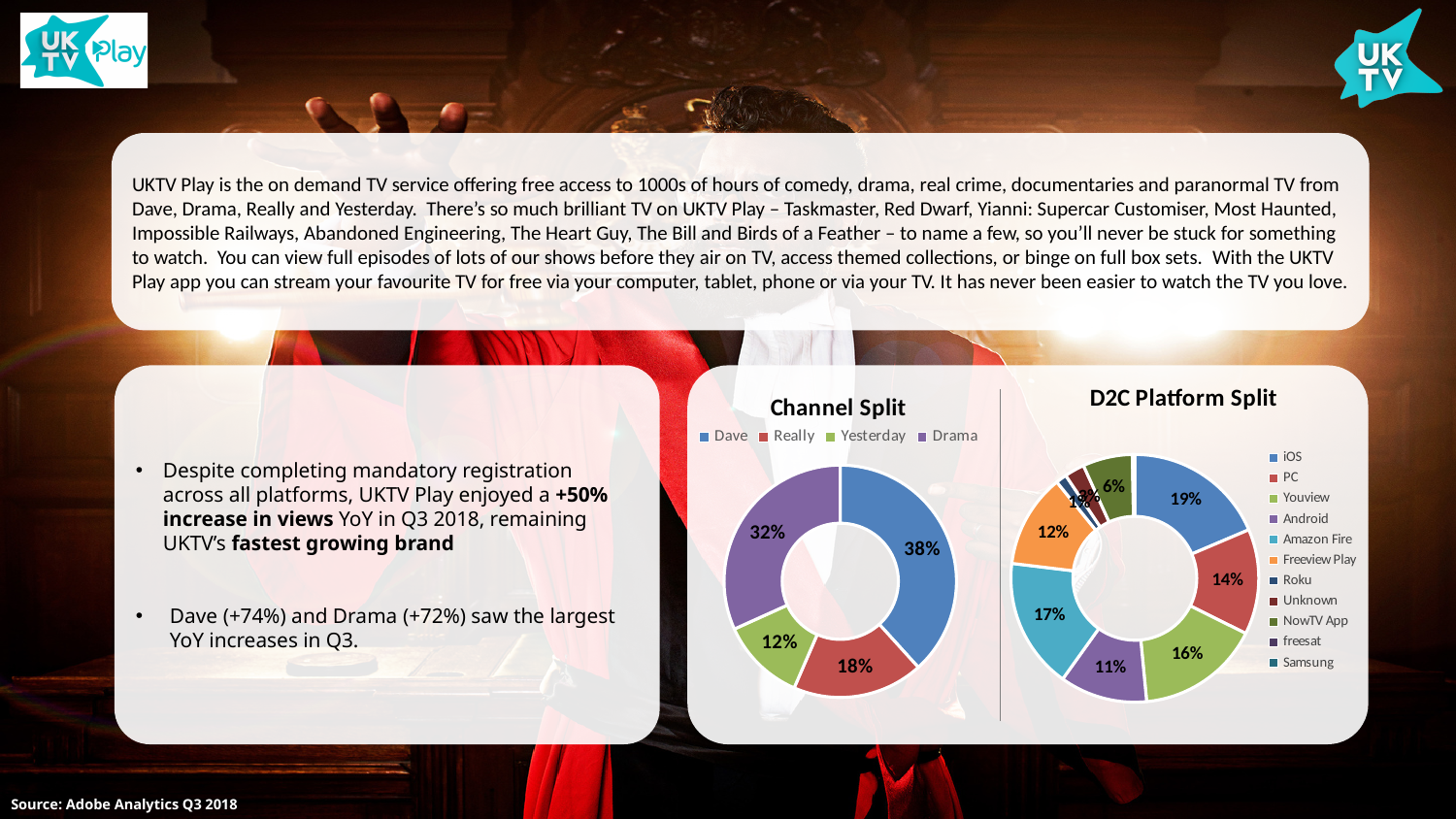
In the D2C Platform Split chart, what is the difference between the iOS and Android shares? 8% In the D2C Platform Split chart, what percentage is shown for Amazon Fire? 17% In the D2C Platform Split chart, which is larger, the share for PC or the share for Youview? Youview How many platforms does the legend of the D2C Platform Split chart list? 11 In the Channel Split chart, what percentage is shown for Dave? 38% In the Channel Split chart, which channel has the largest share? Dave In the D2C Platform Split chart, what percentage is shown for iOS? 19% In the Channel Split chart, what is the difference between the Dave and Really shares? 20% How many channels does the legend of the Channel Split chart list? 4 In the Channel Split chart, what percentage is shown for Drama? 32% What kind of chart is the Channel Split chart? Donut (pie) chart In the Channel Split chart, which channel has the smallest share? Yesterday